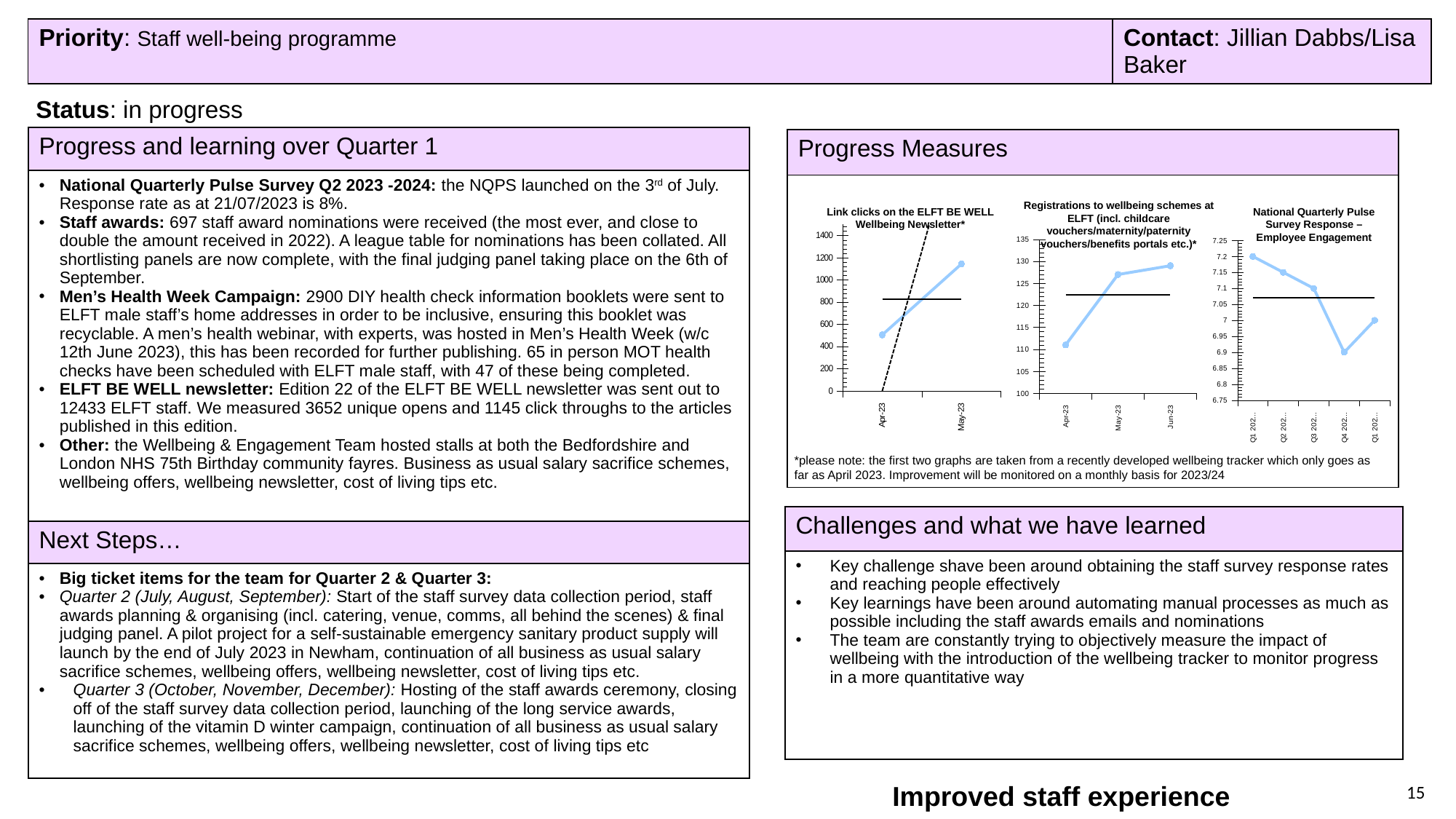
In the 'Registrations to wellbeing schemes at ELFT' chart, is the value for Jun-23 greater or less than 125? greater How many charts are shown in the Progress Measures section? 3 What type of chart is 'Link clicks on the ELFT BE WELL Wellbeing Newsletter'? Line chart In the 'Link clicks on the ELFT BE WELL Wellbeing Newsletter' chart, how many months are plotted? 2 In the 'Registrations to wellbeing schemes at ELFT' chart, is the value for Apr-23 greater or less than 115? less In the 'Registrations to wellbeing schemes at ELFT' chart, which month has the lowest value? Apr-23 In the 'National Quarterly Pulse Survey Response – Employee Engagement' chart, is the value for the Q4 point greater or less than 7? less In the 'Link clicks on the ELFT BE WELL Wellbeing Newsletter' chart, do link clicks rise or fall from Apr-23 to May-23? rise In the 'Registrations to wellbeing schemes at ELFT' chart, how many months are plotted? 3 In the 'National Quarterly Pulse Survey Response – Employee Engagement' chart, how many quarters are plotted? 5